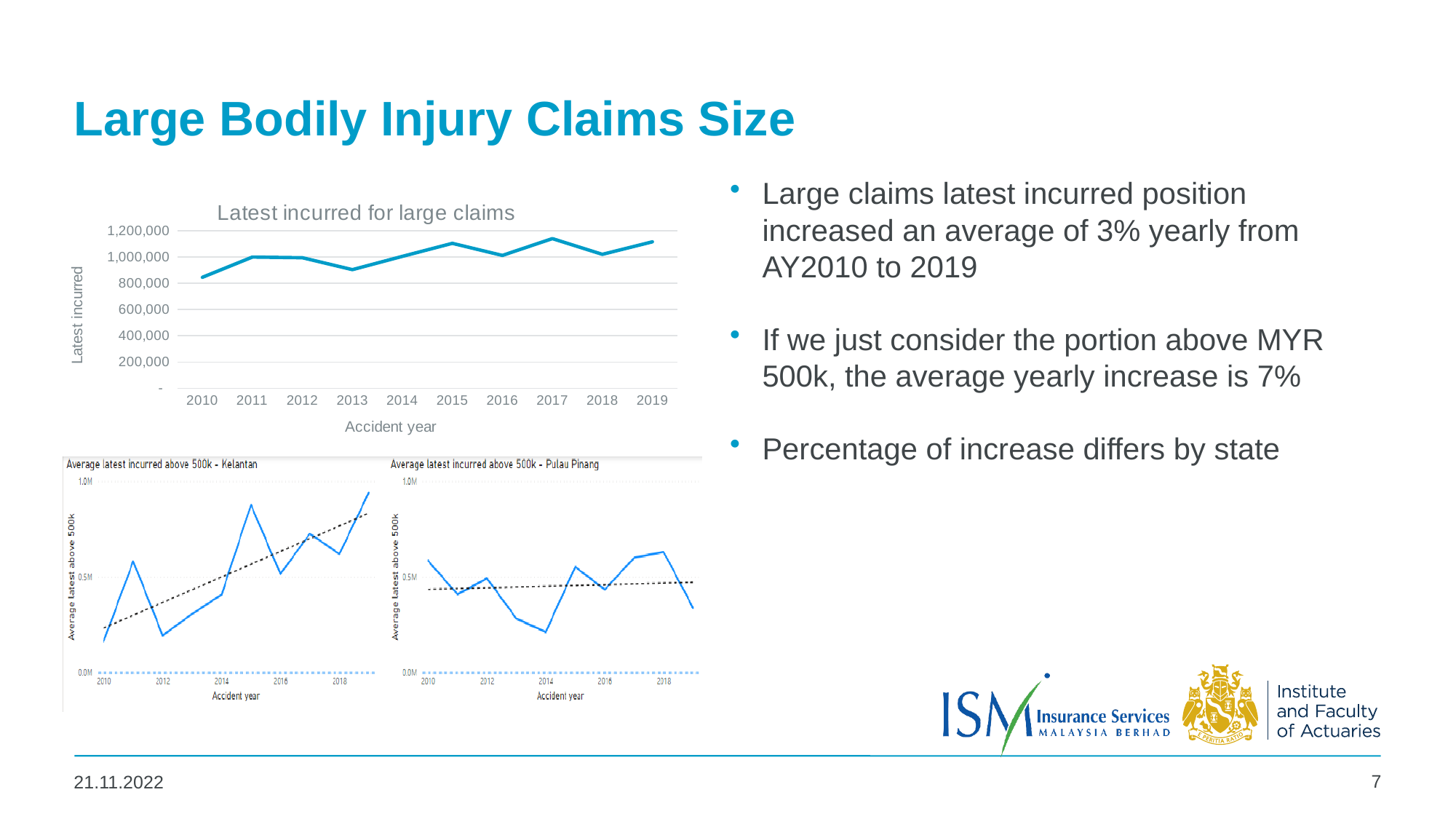
In the "Latest incurred for large claims" chart, is the value for 2013 greater or less than 1,000,000? less In the "Latest incurred for large claims" chart, which accident year has the lowest latest incurred? 2010 In the "Average latest incurred above 500k - Kelantan" chart, is the value for 2012 greater or less than 0.5M? less In the "Average latest incurred above 500k - Pulau Pinang" chart, which accident year has the lowest value? 2014 In the "Latest incurred for large claims" chart, is the value for 2017 greater or less than 1,000,000? greater In the "Average latest incurred above 500k - Kelantan" chart, which accident year has the highest value? 2019 In the "Latest incurred for large claims" chart, which is larger, the value for 2011 or the value for 2013? 2011 In the "Latest incurred for large claims" chart, how many accident years are plotted? 10 What kind of chart is "Latest incurred for large claims"? line chart In the "Latest incurred for large claims" chart, do values generally rise or fall from 2010 to 2019? rise What is the x-axis label of the "Latest incurred for large claims" chart? Accident year